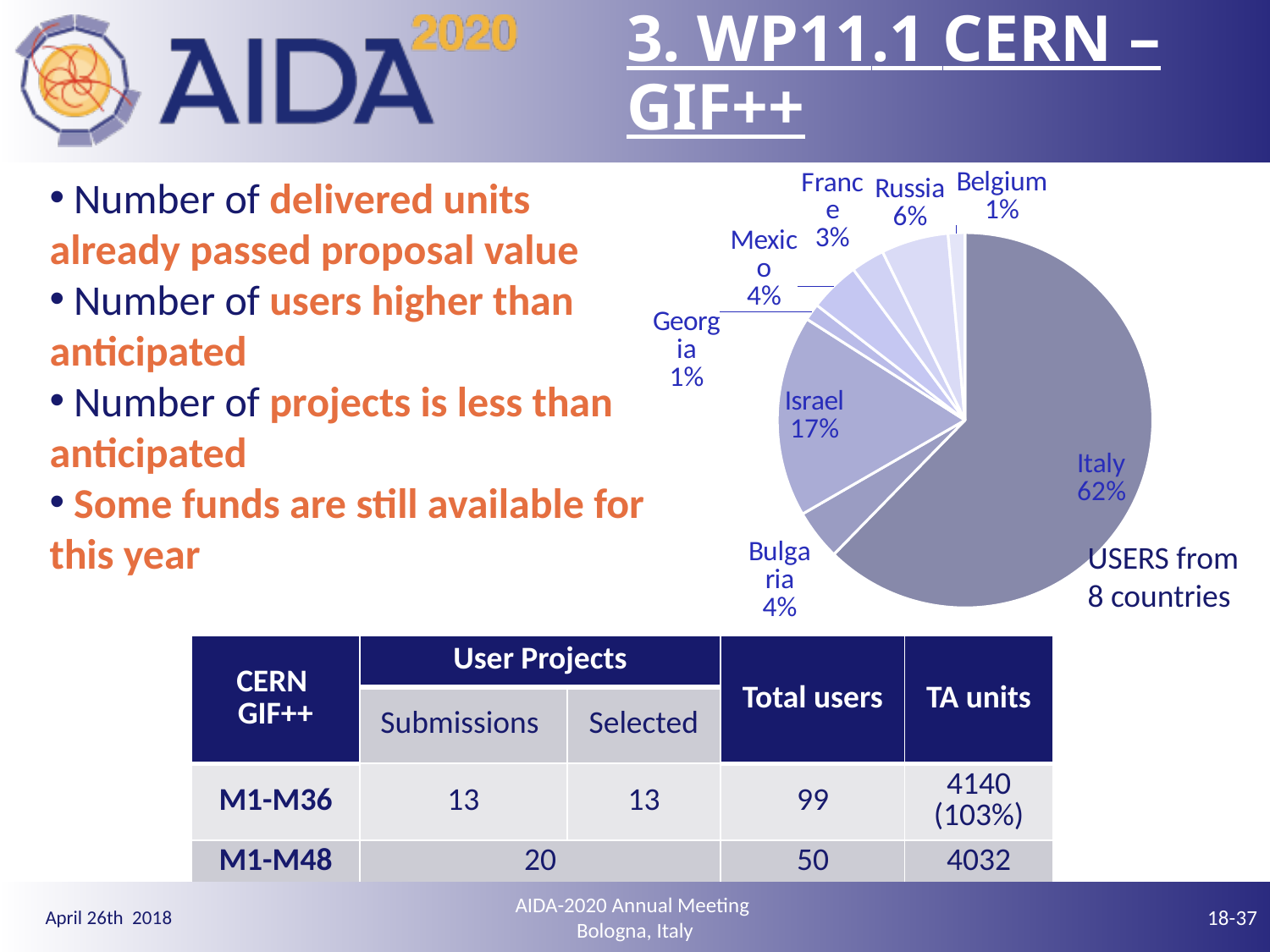
What percentage is shown for Bulgaria in the pie chart? 4% Which country has the largest slice in the pie chart? Italy What is the difference in percentage points between Italy's share and Israel's share in the pie chart? 45 percentage points Which is larger in the pie chart, the share for Israel or the share for Russia? Israel Which is larger in the pie chart, the share for Mexico or the share for France? Mexico What share of users does Israel account for in the pie chart? 17% How many countries (slices) are shown in the pie chart? 8 What share of users does Italy account for in the pie chart? 62% What kind of chart is shown on the slide? pie chart What percentage is shown for France in the pie chart? 3% What text is written next to the pie chart describing the users? USERS from 8 countries What percentage is shown for Russia in the pie chart? 6%